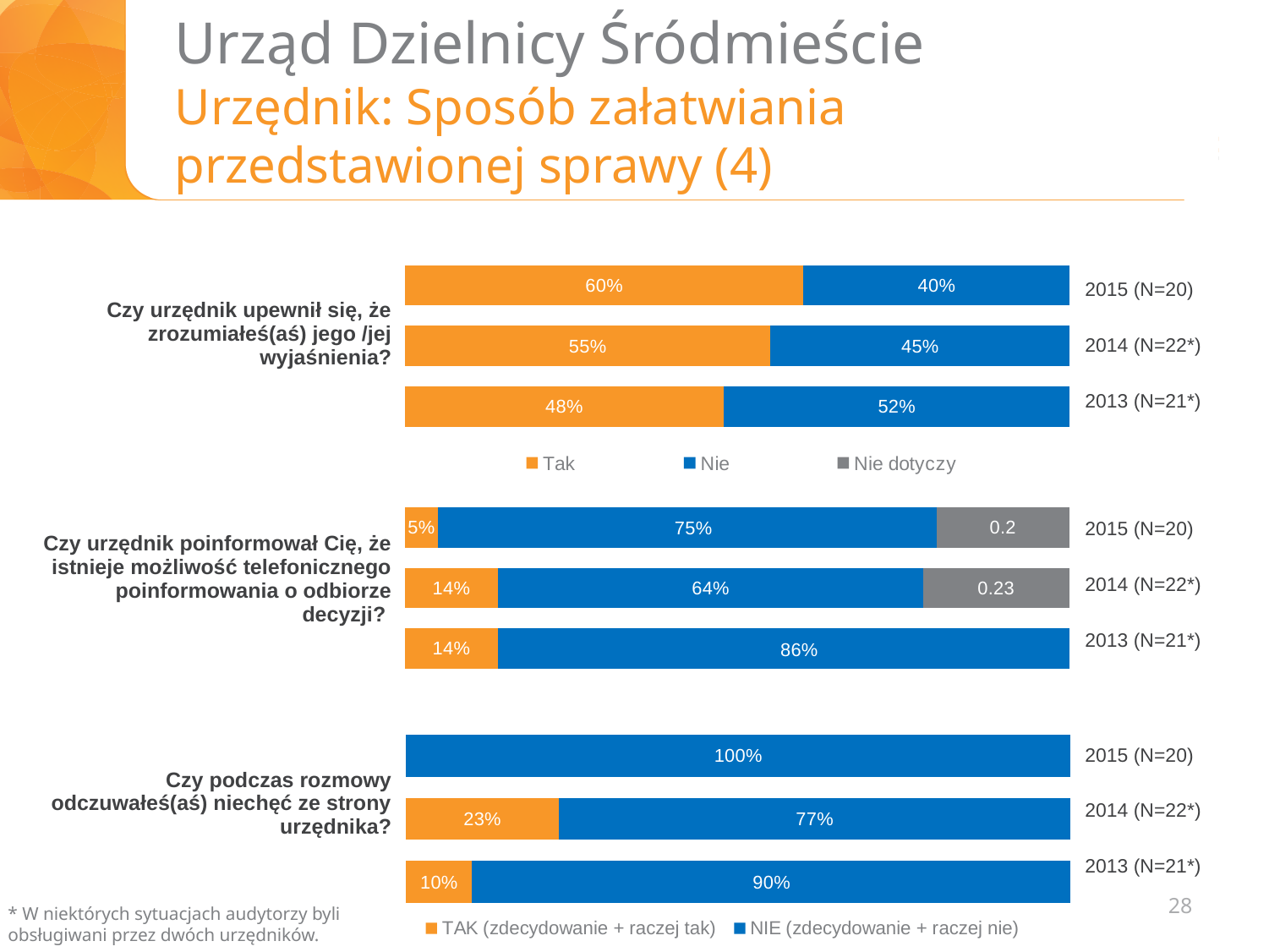
In the chart for "Czy podczas rozmowy odczuwałeś(aś) niechęć ze strony urzędnika?", what is the NIE value for 2015 (N=20)? 100% In the chart for "Czy urzędnik upewnił się, że zrozumiałeś(aś) jego /jej wyjaśnienia?", which year has the highest Tak value? 2015 (N=20) In the chart for "Czy podczas rozmowy odczuwałeś(aś) niechęć ze strony urzędnika?", what is the difference between the NIE values for 2013 and 2014? 13% In the chart for "Czy urzędnik upewnił się, że zrozumiałeś(aś) jego /jej wyjaśnienia?", what is the Tak value for 2015 (N=20)? 60% In the chart for "Czy urzędnik upewnił się, że zrozumiałeś(aś) jego /jej wyjaśnienia?", what is the Nie value for 2013 (N=21*)? 52% In the chart for "Czy urzędnik poinformował Cię, że istnieje możliwość telefonicznego poinformowania o odbiorze decyzji?", what is the Nie dotyczy value for 2014 (N=22*)? 0.23 How many series does the legend below the top chart list? 3 In the chart for "Czy urzędnik upewnił się, że zrozumiałeś(aś) jego /jej wyjaśnienia?", what is the difference between the Tak values for 2015 and 2013? 12% What kind of chart is used on this slide? Stacked bar chart In the chart for "Czy urzędnik poinformował Cię, że istnieje możliwość telefonicznego poinformowania o odbiorze decyzji?", what is the Nie value for 2013 (N=21*)? 86% In the chart for "Czy podczas rozmowy odczuwałeś(aś) niechęć ze strony urzędnika?", is the TAK value larger for 2014 (N=22*) or 2013 (N=21*)? 2014 (N=22*) In the chart for "Czy urzędnik poinformował Cię, że istnieje możliwość telefonicznego poinformowania o odbiorze decyzji?", which year has the lowest Tak value? 2015 (N=20)